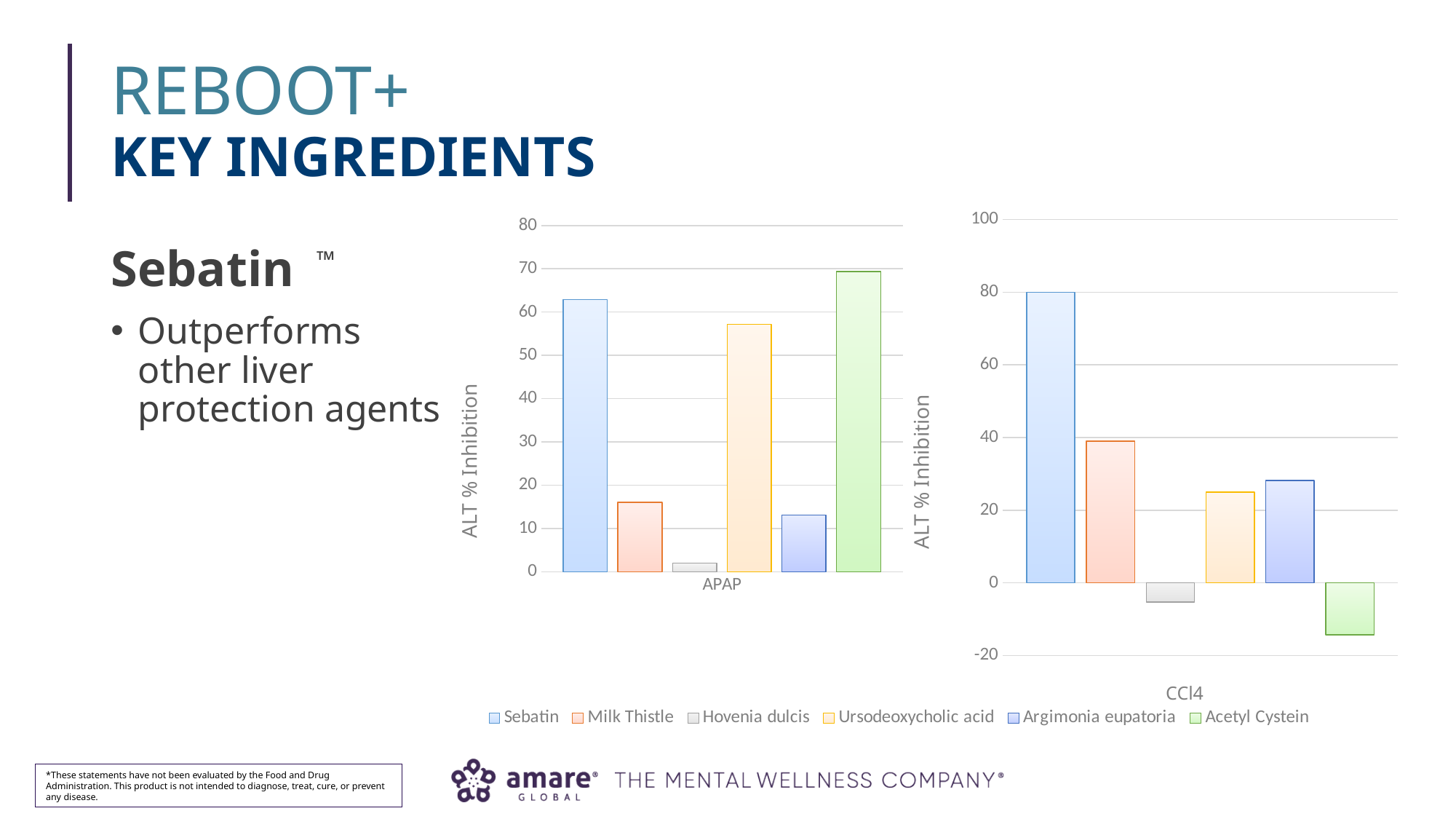
What is the y-axis title of the CCl4 chart? ALT % Inhibition In the APAP chart, which series has the highest ALT % Inhibition? Acetyl Cystein In the CCl4 chart, which series has the lowest ALT % Inhibition? Acetyl Cystein In the APAP chart, is the value for Milk Thistle greater or less than 20? less In the APAP chart, which is larger: the value for Sebatin or the value for Ursodeoxycholic acid? Sebatin In the CCl4 chart, is the value for Milk Thistle greater or less than 20? greater How many series does the shared legend list for the charts? 6 In the CCl4 chart, which series has the highest ALT % Inhibition? Sebatin What kind of chart is the APAP chart on the left? bar chart In the APAP chart, which series has the lowest ALT % Inhibition? Hovenia dulcis In the APAP chart, is the value for Sebatin greater or less than 60? greater